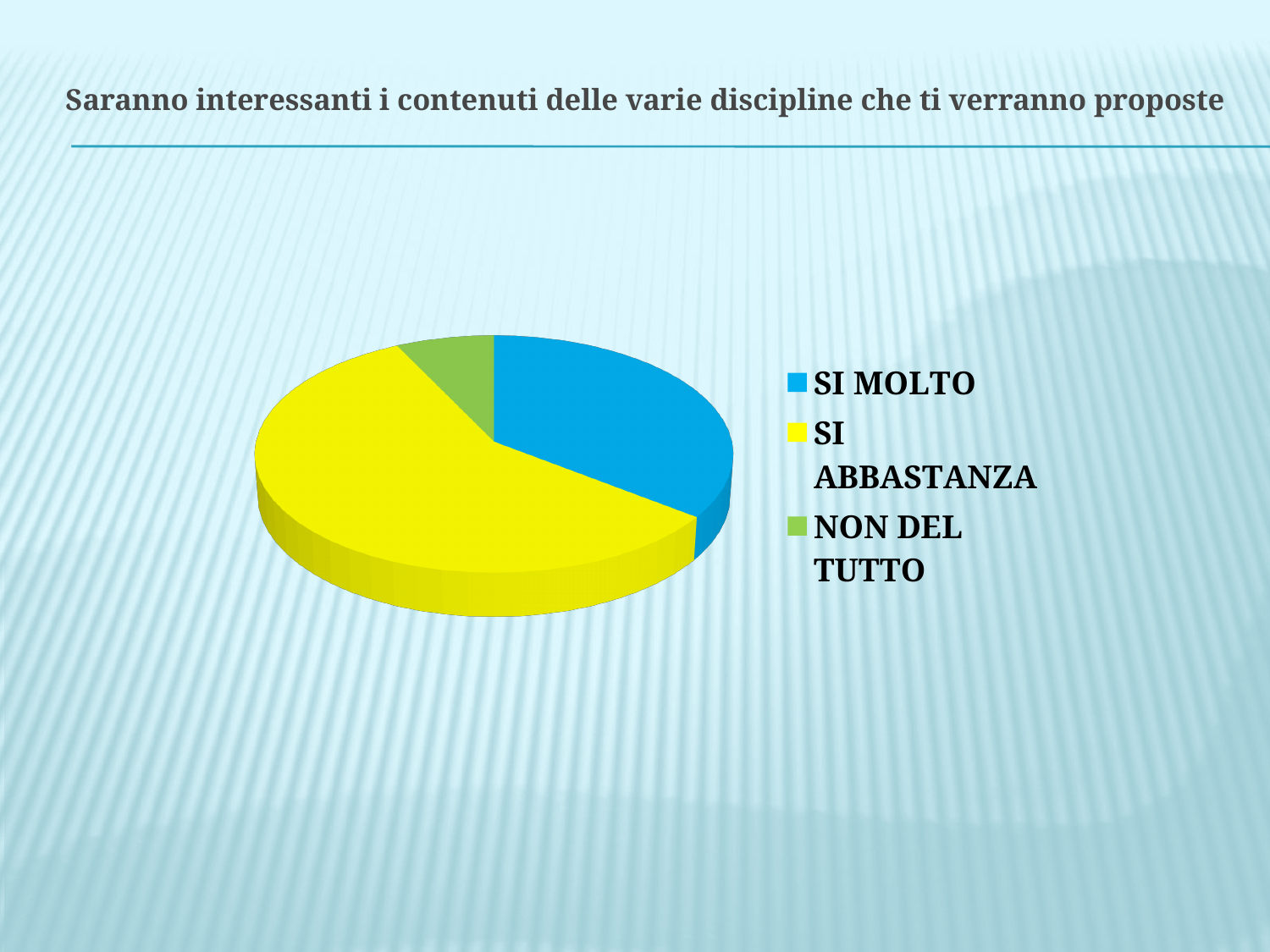
What kind of chart is shown on the slide? Pie chart What is the title of the slide containing the pie chart? Saranno interessanti i contenuti delle varie discipline che ti verranno proposte Which colour represents SI MOLTO in the pie chart? Blue Which slice is larger, SI MOLTO or NON DEL TUTTO? SI MOLTO Which category has the largest slice of the pie chart? SI ABBASTANZA Which category has the smallest slice of the pie chart? NON DEL TUTTO Is the share of SI ABBASTANZA greater or less than half of the pie? greater Which slice is larger, SI ABBASTANZA or SI MOLTO? SI ABBASTANZA How many categories does the pie chart show? 3